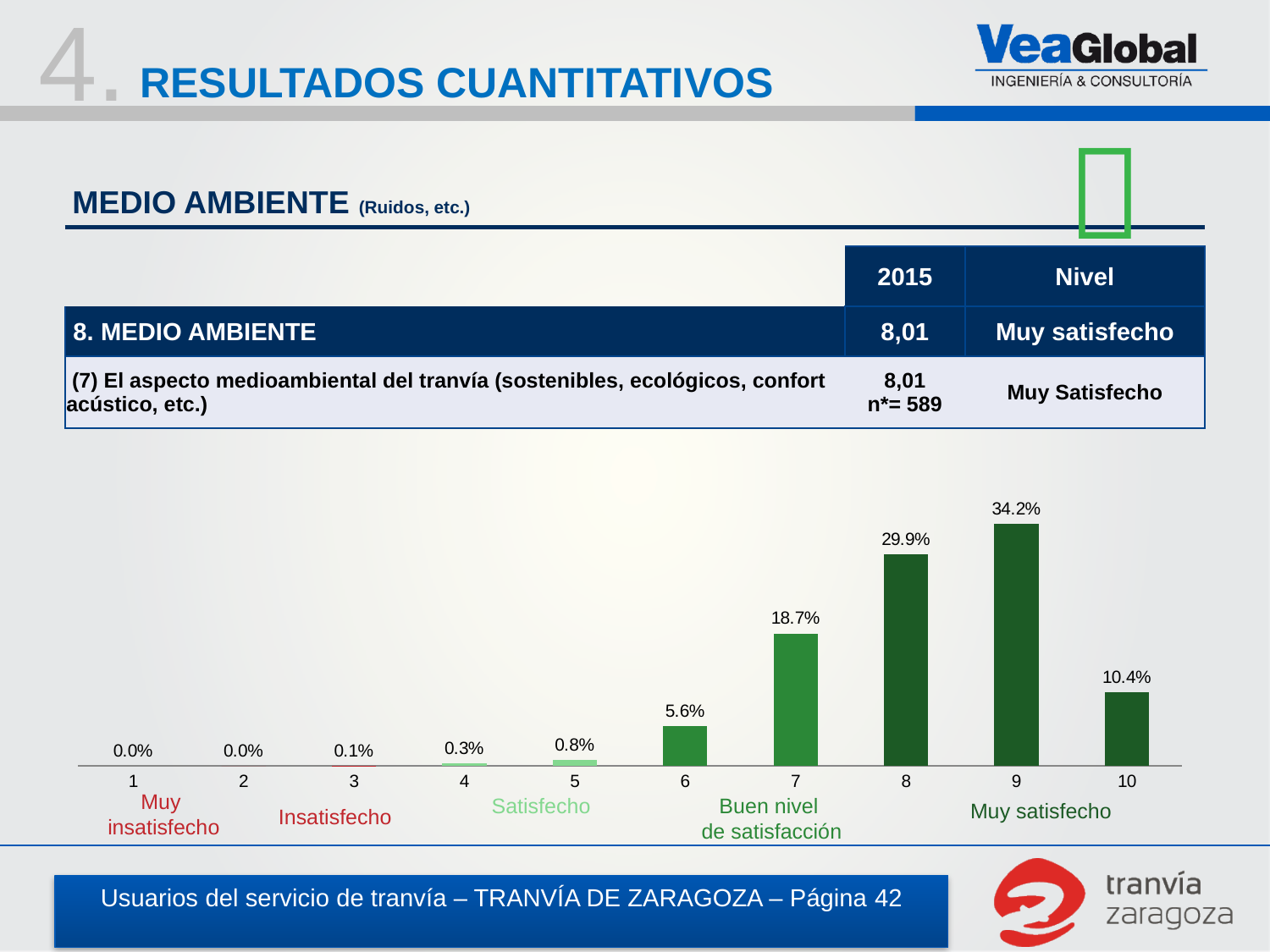
What percentage is shown for category 9 in the bar chart? 34.2% What is the difference between the percentages for categories 9 and 8? 4.3% What kind of chart is shown on the slide? bar chart Do the percentages rise or fall from category 1 to category 9? rise Which is larger, the percentage for category 6 or for category 10? 10 What is the combined percentage for categories 8 and 9? 64.1% Which category has the highest percentage in the bar chart? 9 What percentage is shown for category 7 in the bar chart? 18.7% What percentage is shown for category 10 in the bar chart? 10.4% How many categories are shown on the x axis of the bar chart? 10 What is the difference between the percentages for categories 8 and 7? 11.2% What percentage is shown for category 5 in the bar chart? 0.8%